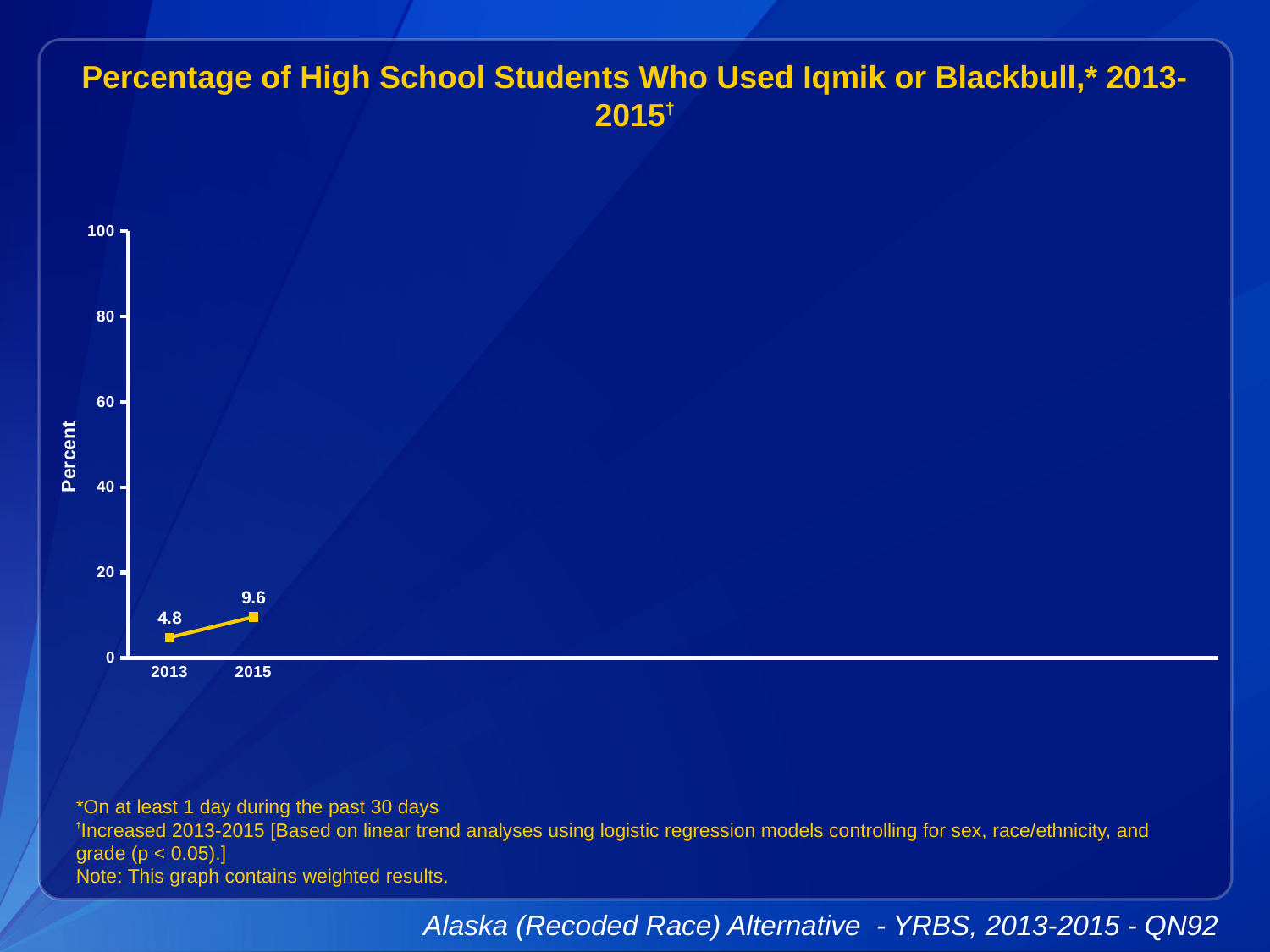
What is the maximum value shown on the y axis? 100 Do the values rise or fall from 2013 to 2015? rise Which year has the highest value? 2015 Is the value for 2015 greater or less than 20? less Which is larger, the value for 2013 or the value for 2015? 2015 What is the label on the y axis? Percent How many data points are plotted on the chart? 2 What is the difference between the values for 2015 and 2013? 4.8 What kind of chart is shown on the slide? line chart What is the value for 2015? 9.6 Which year has the lowest value? 2013 What is the value for 2013? 4.8